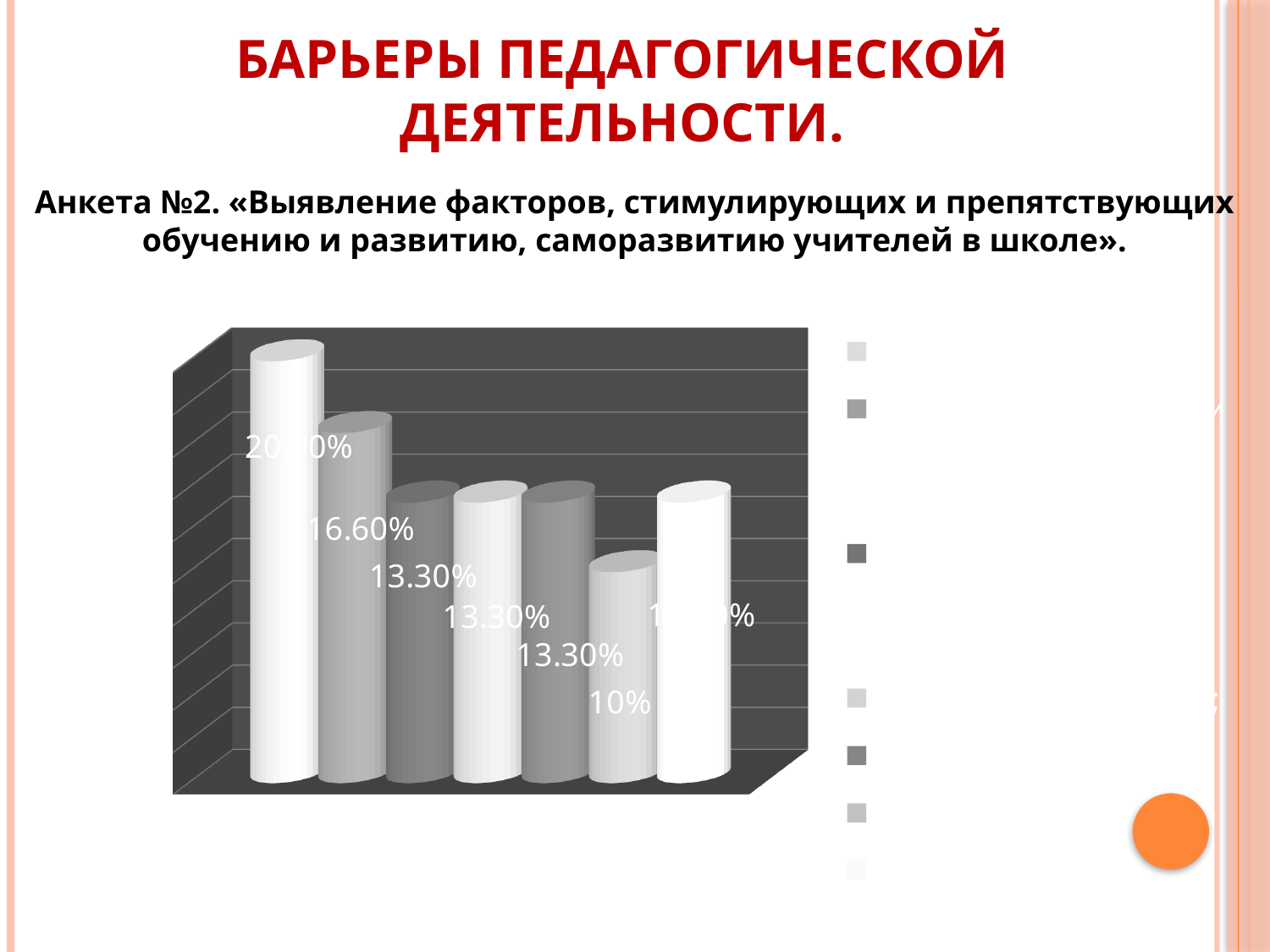
What is the value shown on the first (leftmost) bar? 20.00% Which bar has the lowest value? the sixth bar, 10% What is the value shown on the sixth bar from the left? 10% Which is larger, the value of the second bar or the value of the third bar? the second bar (16.60%) What is the value shown on the third bar from the left? 13.30% How many bars does the chart contain? 7 What is the difference between the second bar (16.60%) and the sixth bar (10%)? 6.60% Which bar has the highest value? the first (leftmost) bar, 20.00% Do the values rise or fall from the first bar to the sixth bar? fall What is the value shown on the second bar from the left? 16.60% What is the difference between the first bar (20.00%) and the second bar (16.60%)? 3.40% What kind of chart is shown on the slide? bar chart